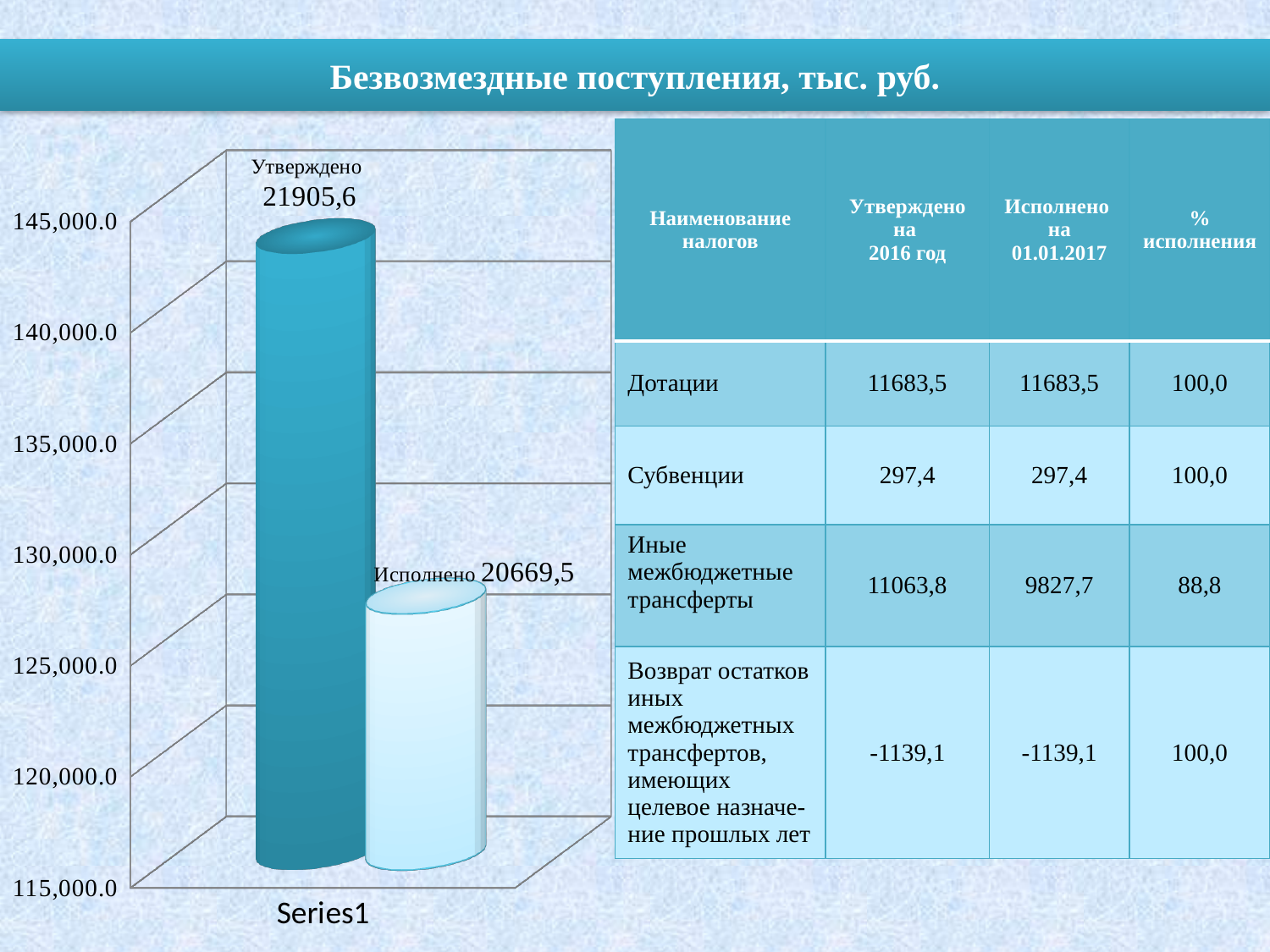
Which bar in the chart is the highest? Утверждено What label appears under the bars on the x axis of the chart? Series1 What kind of chart is shown on the slide? Bar chart How many bars are plotted in the chart? 2 What is the title shown above the chart on the slide? Безвозмездные поступления, тыс. руб. What value is shown for the Утверждено bar in the chart? 21905,6 Which bar in the chart is the lowest? Исполнено What is the difference between the Утверждено and Исполнено values in the chart? 1236,1 What value is shown for the Исполнено bar in the chart? 20669,5 Which is larger in the chart, Утверждено or Исполнено? Утверждено